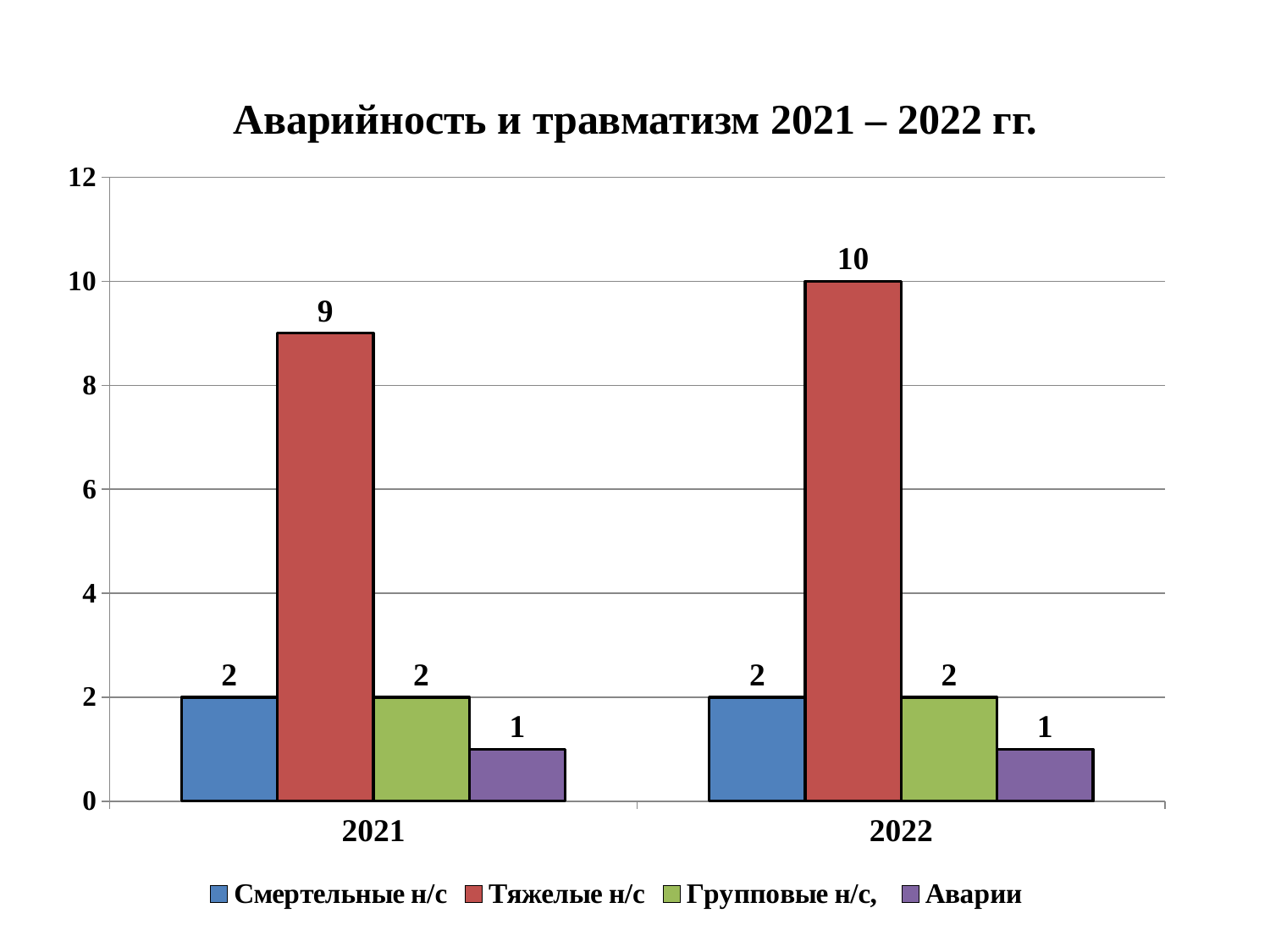
How many year categories are shown on the x axis? 2 What is the value for Тяжелые н/с in 2022? 10 What is the difference between the Тяжелые н/с values for 2022 and 2021? 1 Which series has the lowest value in 2021? Аварии Which is larger: Тяжелые н/с in 2021 or Тяжелые н/с in 2022? Тяжелые н/с in 2022 What is the value for Аварии in 2022? 1 Which series has the highest value in 2022? Тяжелые н/с What is the title of the chart? Аварийность и травматизм 2021 – 2022 гг. What is the value for Смертельные н/с in 2021? 2 What is the value for Тяжелые н/с in 2021? 9 How many series does the legend list? 4 What kind of chart is shown on the slide? Bar chart